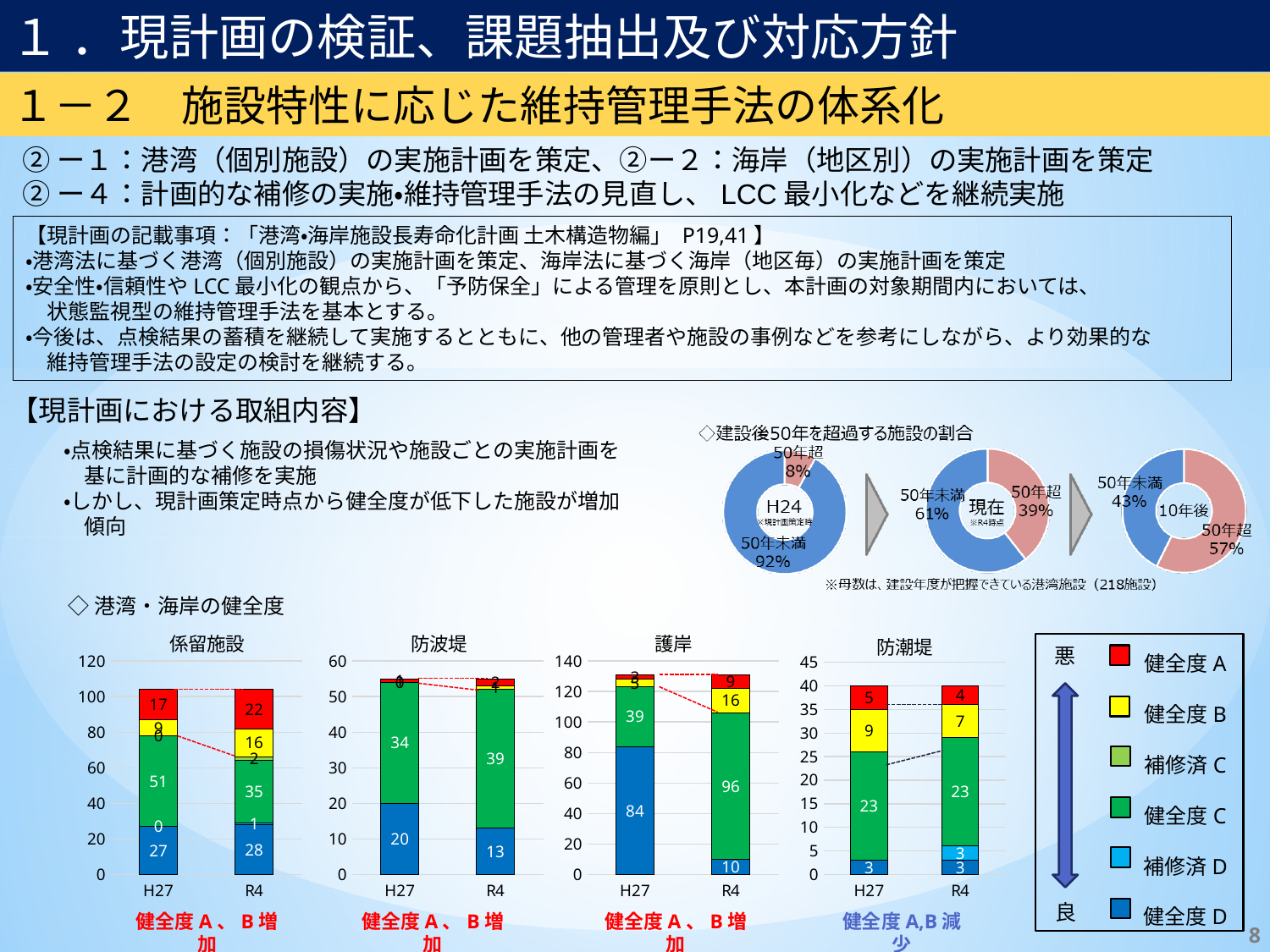
In the 係留施設 chart, what is the value of 健全度C for H27? 51 In the 防潮堤 chart, what is the total of the H27 stacked bar? 40 In the 係留施設 chart, which year has the larger 健全度A value, H27 or R4? R4 In the 護岸 chart, what is the difference between the 健全度D values for H27 and R4? 74 In the 防潮堤 chart, what is the value of 健全度B for H27? 9 In the 護岸 chart, what is the value of 健全度D for H27? 84 How many series does the legend next to the 港湾・海岸の健全度 charts list? 6 In the H24 donut chart under 建設後50年を超過する施設の割合, what share is 50年超? 8% In the 護岸 chart, what is the value of 健全度C for R4? 96 In the 10年後 donut chart, what share is 50年超? 57% In the 防波堤 chart, what is the value of 健全度D for H27? 20 In the 係留施設 chart, what is the value of 健全度A for R4? 22